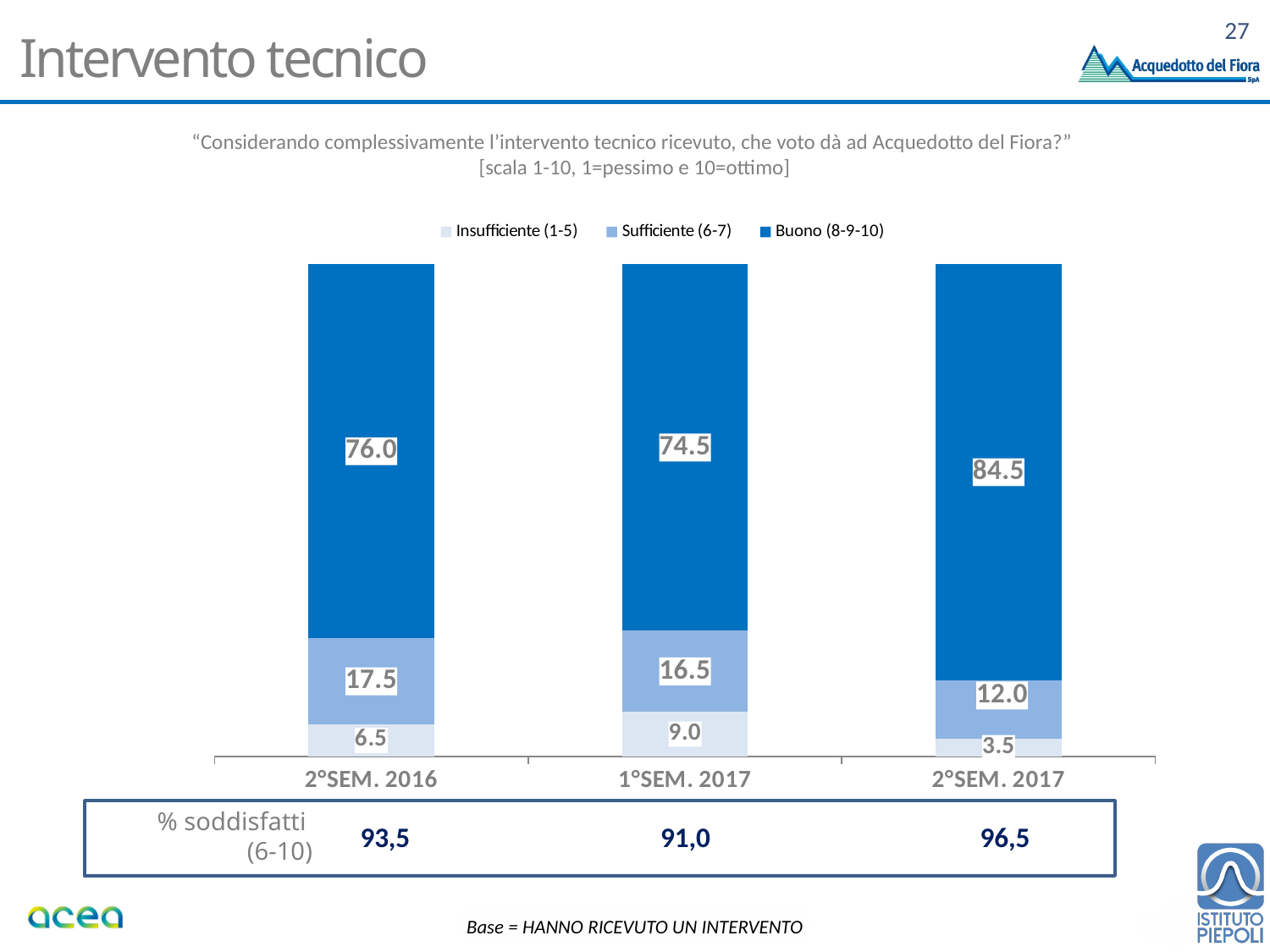
Which period has the lowest value for Insufficiente (1-5)? 2°SEM. 2017 What is the value of Buono (8-9-10) for 2°SEM. 2017? 84.5 What kind of chart is shown on the slide? Stacked bar chart What is the value of Insufficiente (1-5) for 1°SEM. 2017? 9.0 How many periods are shown on the x axis? 3 What is the difference between the Buono (8-9-10) values for 2°SEM. 2017 and 1°SEM. 2017? 10.0 What is the total of the stacked bar for 2°SEM. 2016? 100.0 Which is larger, the Sufficiente (6-7) value for 2°SEM. 2016 or for 1°SEM. 2017? 2°SEM. 2016 What is the value of Sufficiente (6-7) for 2°SEM. 2016? 17.5 How many series does the legend list? 3 Which period has the highest value for Buono (8-9-10)? 2°SEM. 2017 Which series is shown in the darkest blue colour? Buono (8-9-10)